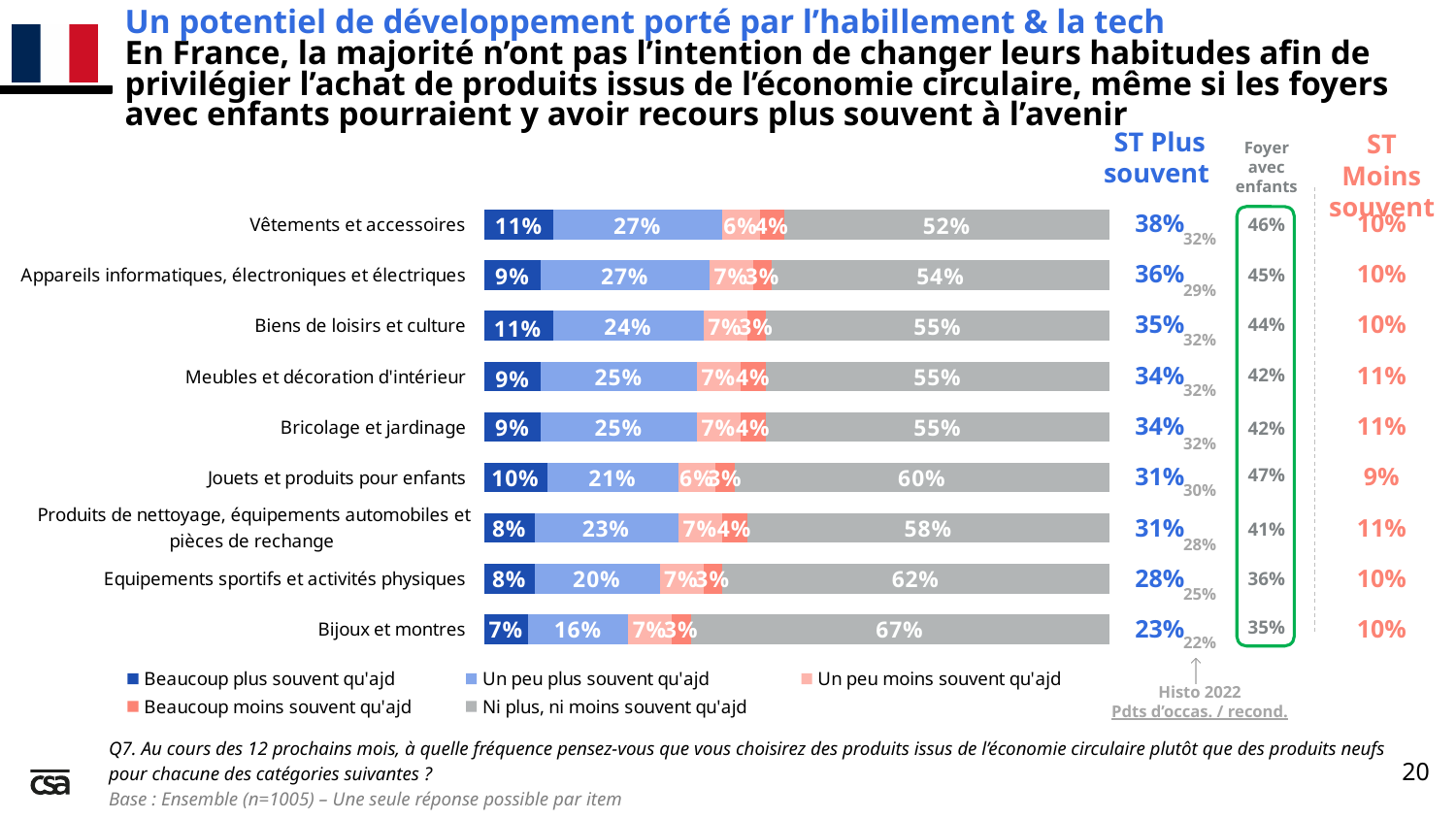
What is the difference between the 'Un peu plus souvent qu'ajd' values for Vêtements et accessoires and Bijoux et montres? 11 points What is the value of 'Ni plus, ni moins souvent qu'ajd' for Bijoux et montres? 67% Which category has the lowest value for 'Beaucoup plus souvent qu'ajd'? Bijoux et montres What is the value of 'Un peu plus souvent qu'ajd' for Jouets et produits pour enfants? 21% How many product categories are plotted in the chart? 9 Which has the larger 'Ni plus, ni moins souvent qu'ajd' value: Jouets et produits pour enfants or Vêtements et accessoires? Jouets et produits pour enfants How many series does the chart legend list? 5 What is the 'Foyer avec enfants' value shown for Jouets et produits pour enfants? 47% Which category has the highest value for 'Ni plus, ni moins souvent qu'ajd'? Bijoux et montres What is the 'ST Plus souvent' value shown for Vêtements et accessoires? 38% What is the value of 'Beaucoup plus souvent qu'ajd' for Vêtements et accessoires? 11% What kind of chart is shown on the slide? Stacked bar chart